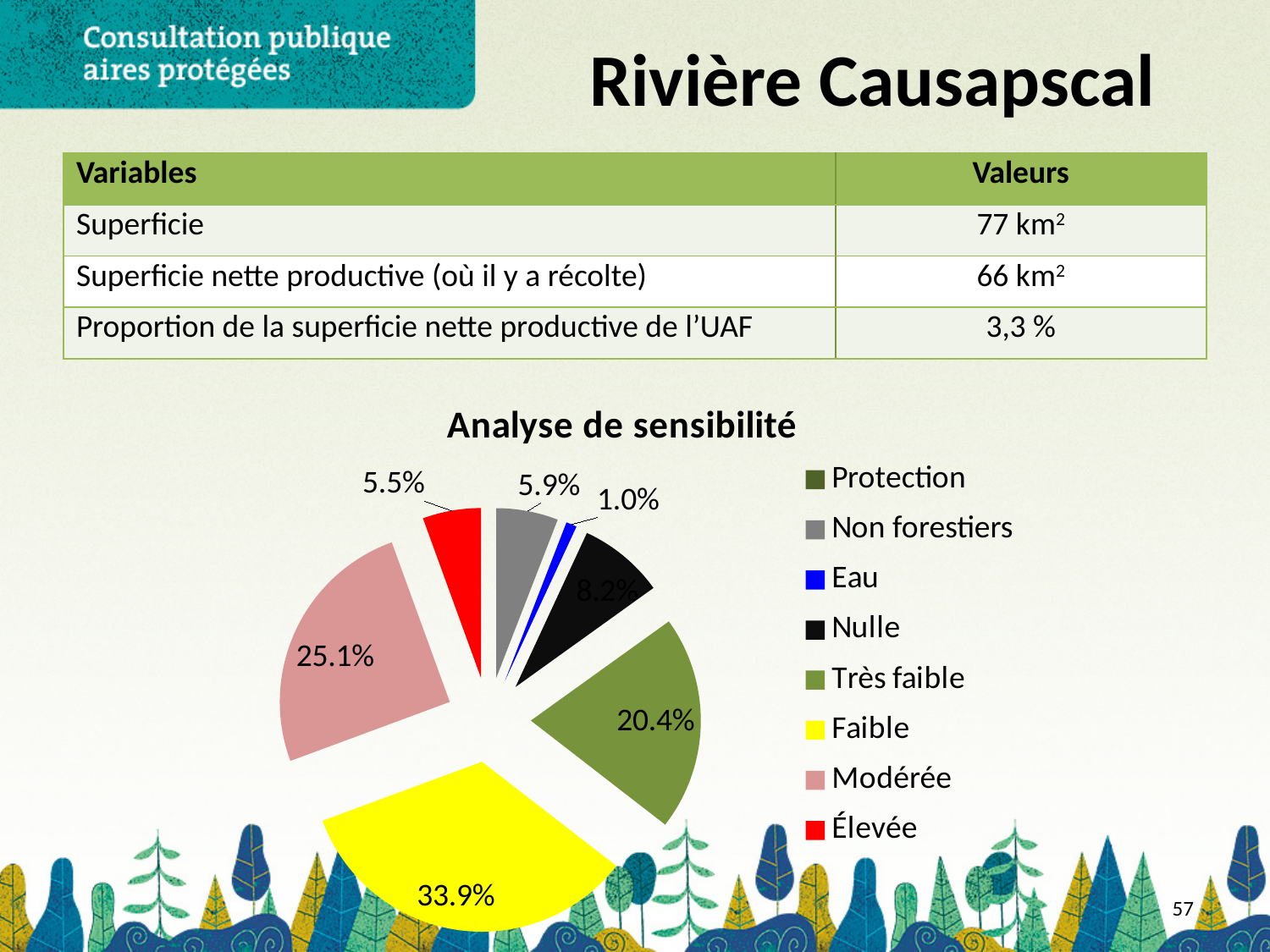
What is the value for Élevée in the pie chart? 5.5% What is the difference between the Faible and Modérée values in the pie chart? 8.8% How many entries does the legend of the pie chart list? 8 What is the value for Nulle in the pie chart? 8.2% What is the value for Très faible in the pie chart? 20.4% What is the value for Eau in the pie chart? 1.0% Which category has the largest slice in the pie chart? Faible Which is larger in the pie chart, Non forestiers or Élevée? Non forestiers What type of chart is shown on the slide? Pie chart What is the value for Faible in the Analyse de sensibilité pie chart? 33.9% Which of the labelled slices in the pie chart is the smallest? Eau What is the value for Modérée in the pie chart? 25.1%